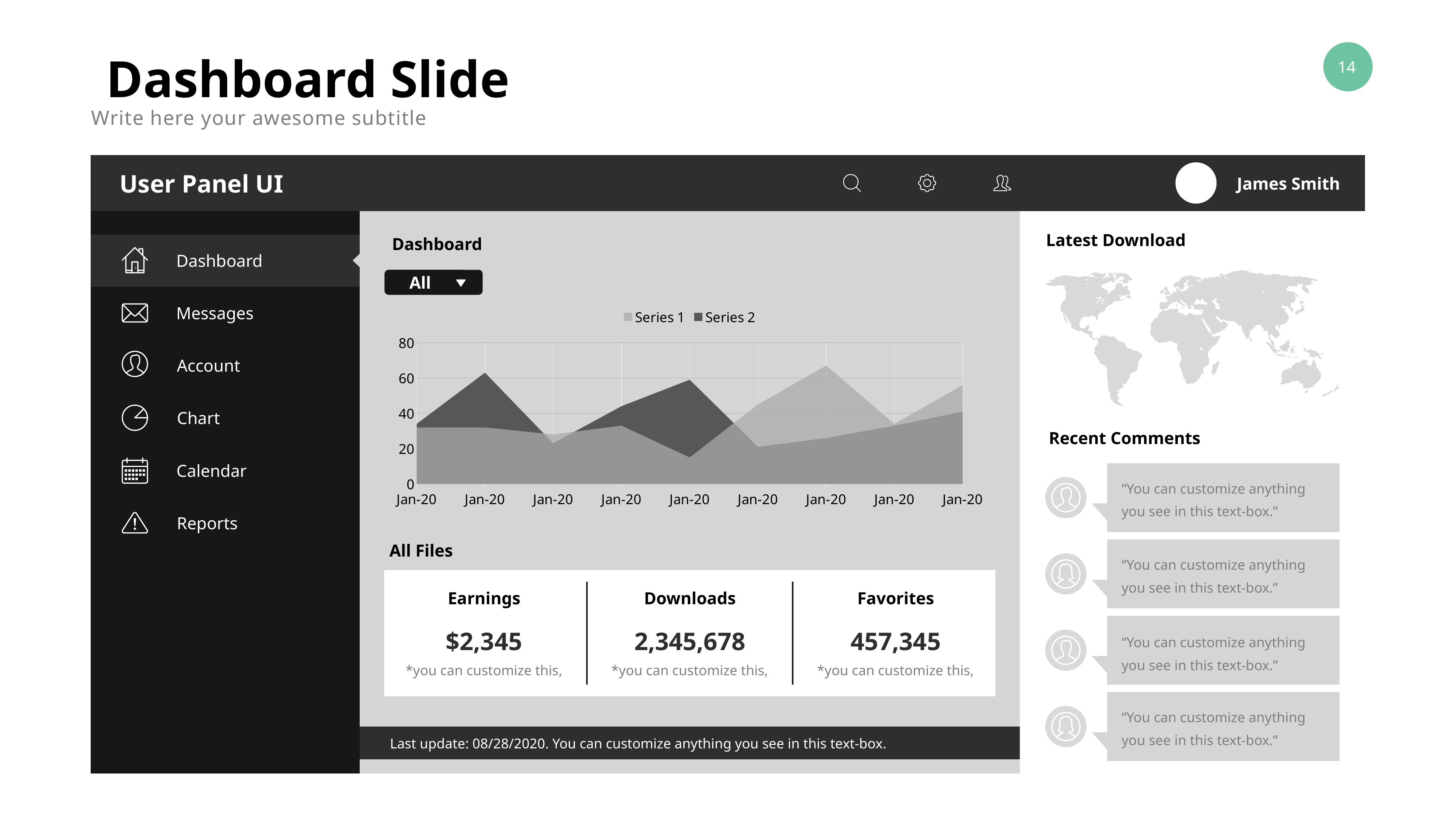
At the second point from the left, which series has the larger value, Series 1 or Series 2? Series 2 At the seventh point from the left, which series has the larger value, Series 1 or Series 2? Series 1 At which point from the left does Series 1 reach its highest value? the seventh point What kind of chart is shown in the Dashboard panel? area chart How many series does the chart legend list? 2 Is the Series 2 value at the second point from the left greater or less than 40? greater How many data points are plotted along the x axis of the chart? 9 What are the two series names shown in the chart legend? Series 1 and Series 2 Is the Series 2 value at the fifth point from the left greater or less than 40? greater What is the highest value shown on the chart's y axis? 80 Is the Series 1 value at the seventh point from the left greater or less than 60? greater